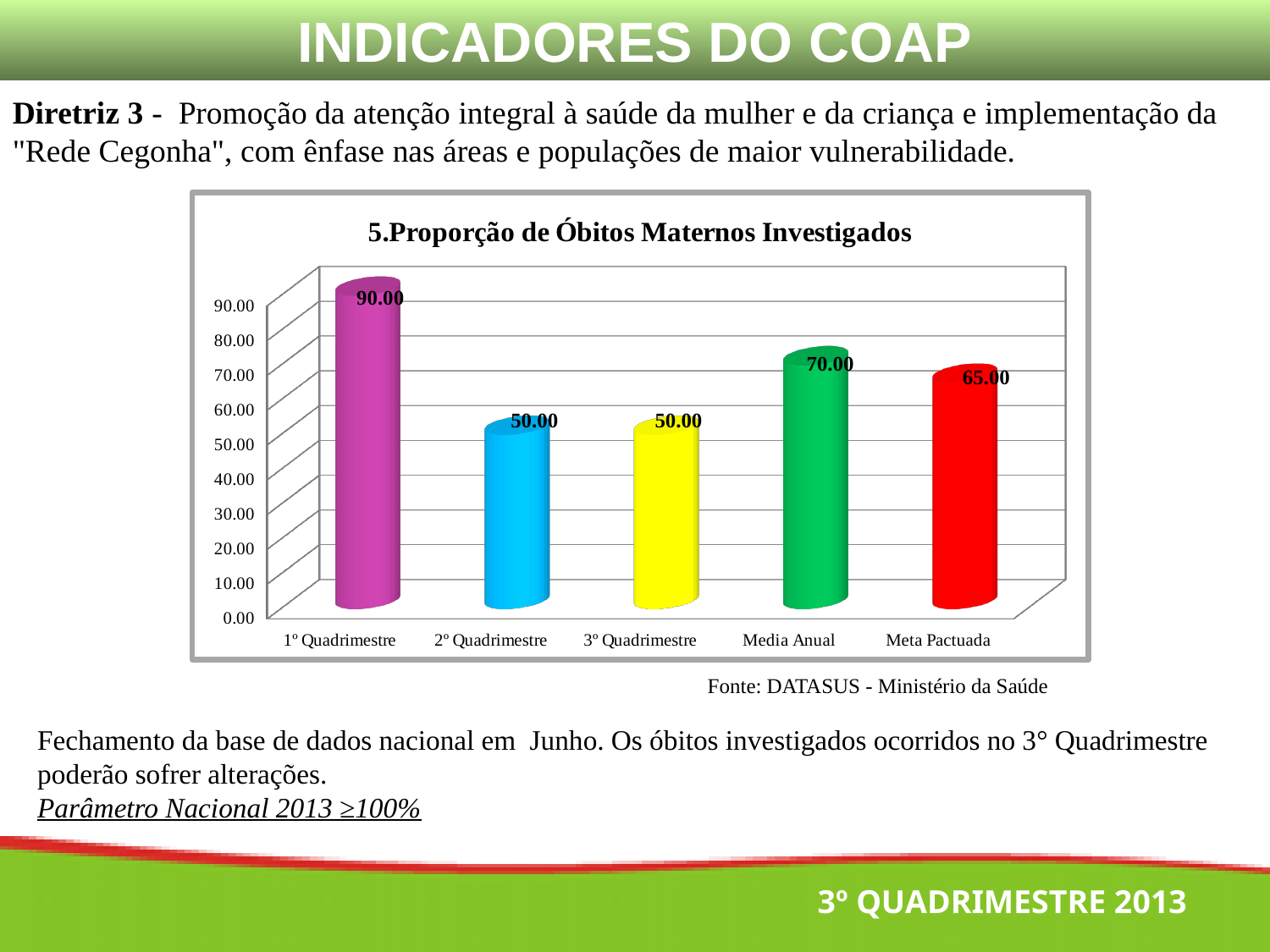
What is the value for 1º Quadrimestre? 90.00 Do the values rise or fall from 1º Quadrimestre to 2º Quadrimestre? fall Which category has the highest value? 1º Quadrimestre What is the value for Media Anual? 70.00 What kind of chart is shown? bar chart How many categories are shown on the x axis? 5 What is the value for 3º Quadrimestre? 50.00 What is the difference between the values for Media Anual and 2º Quadrimestre? 20.00 What is the title of the chart? 5.Proporção de Óbitos Maternos Investigados Which is larger, the value for Media Anual or the value for Meta Pactuada? Media Anual What is the value for Meta Pactuada? 65.00 What is the difference between the values for 1º Quadrimestre and Meta Pactuada? 25.00